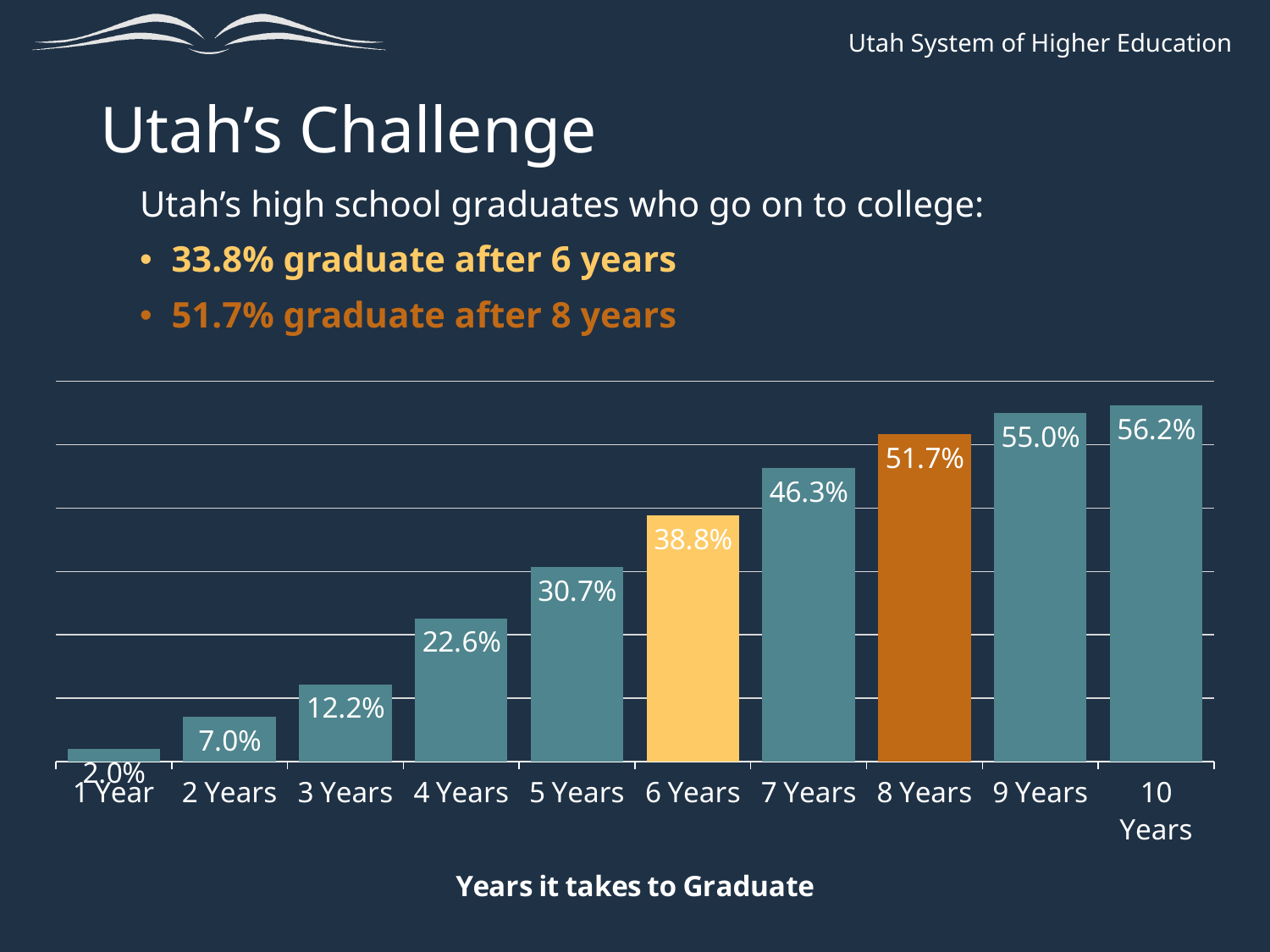
What kind of chart is shown on the slide? Bar chart What is the difference between the values for 5 Years and 4 Years? 8.1% Do the values rise or fall from 1 Year to 10 Years? Rise What is the value for 8 Years? 51.7% What is the value for 10 Years? 56.2% Which category has the lowest value? 1 Year What is the value for 6 Years? 38.8% What is the difference between the values for 8 Years and 6 Years? 12.9% Which category has the highest value? 10 Years How many categories are shown on the x axis? 10 Which is larger, the value for 7 Years or the value for 5 Years? 7 Years What is the value for 3 Years? 12.2%